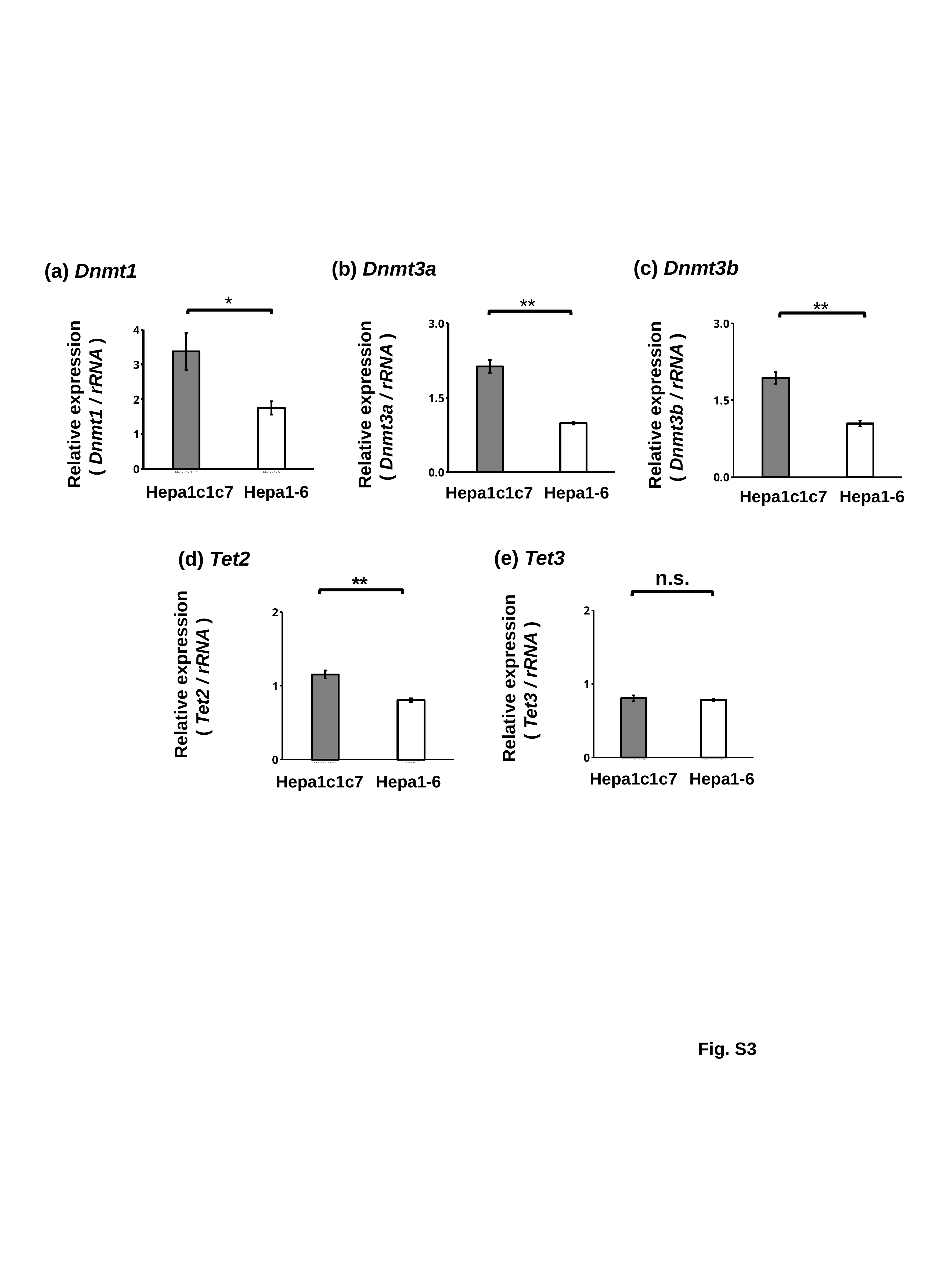
In the Tet2 chart (d), is the value for Hepa1-6 greater or less than 1? less In the Dnmt3b chart (c), which category has the lowest value? Hepa1-6 What kind of chart is the Dnmt1 chart (a)? bar chart In the Dnmt3b chart (c), is the value for Hepa1c1c7 greater or less than 1.5? greater In the Tet2 chart (d), which category has the highest value? Hepa1c1c7 In the Dnmt1 chart (a), is the value for Hepa1-6 greater or less than 2? less How many categories are shown on the x axis of the Tet2 chart (d)? 2 In the Dnmt1 chart (a), which category has the higher value, Hepa1c1c7 or Hepa1-6? Hepa1c1c7 What significance label is shown above the bars in the Tet3 chart (e)? n.s.